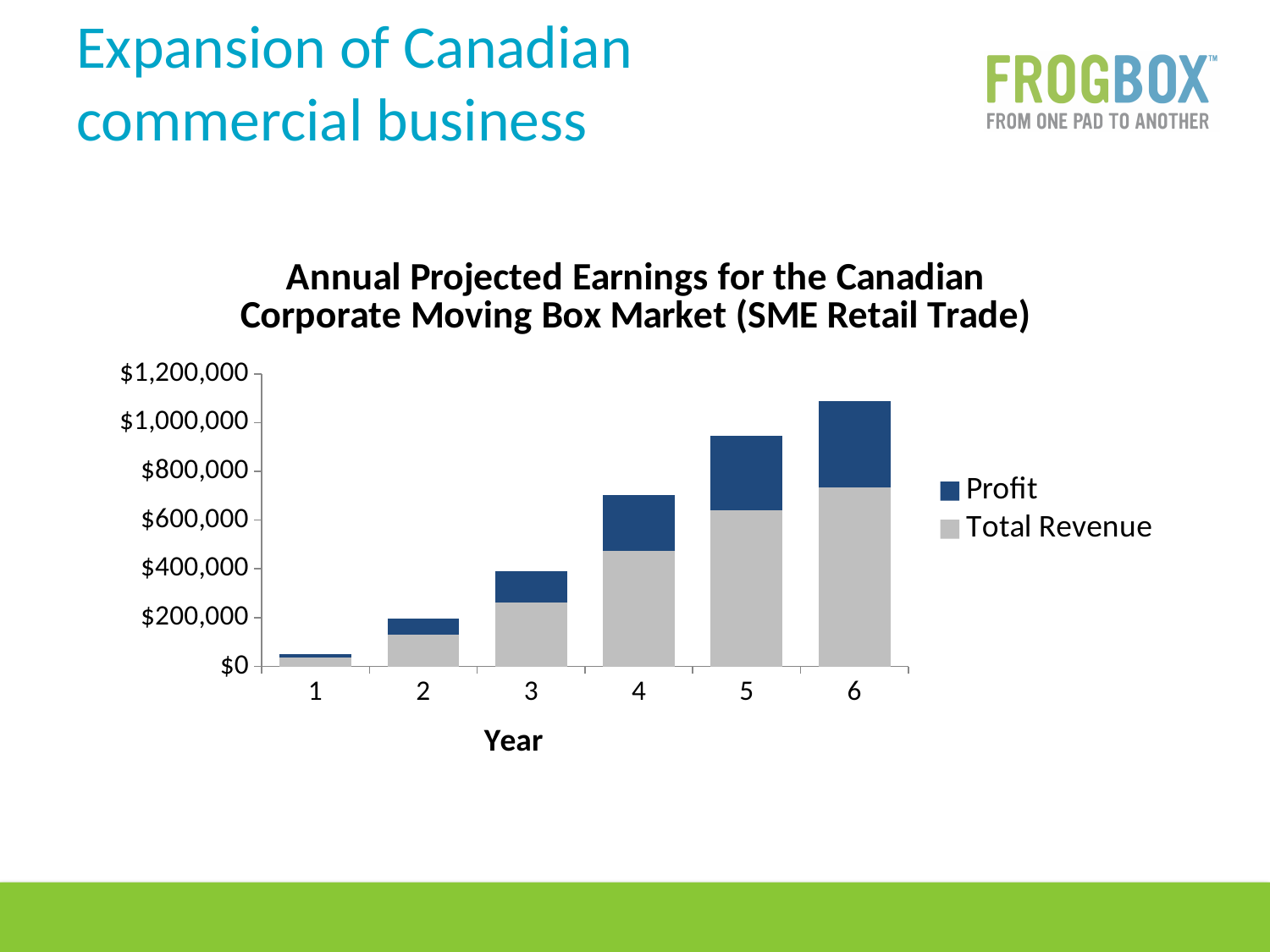
How many series does the legend list? 2 Do the stacked bar totals rise or fall from Year 1 to Year 6? Rise How many years are shown on the x axis? 6 What is the title of the chart? Annual Projected Earnings for the Canadian Corporate Moving Box Market (SME Retail Trade) Which year has the tallest stacked bar? 6 Is the total of the stacked bar for Year 6 greater or less than $1,000,000? greater What kind of chart is shown on the slide? Stacked bar chart Is the Total Revenue value for Year 4 greater or less than $600,000? less Is the Total Revenue value for Year 6 greater or less than $600,000? greater Which is larger, the stacked bar total for Year 5 or for Year 3? Year 5 Which year has the shortest stacked bar? 1